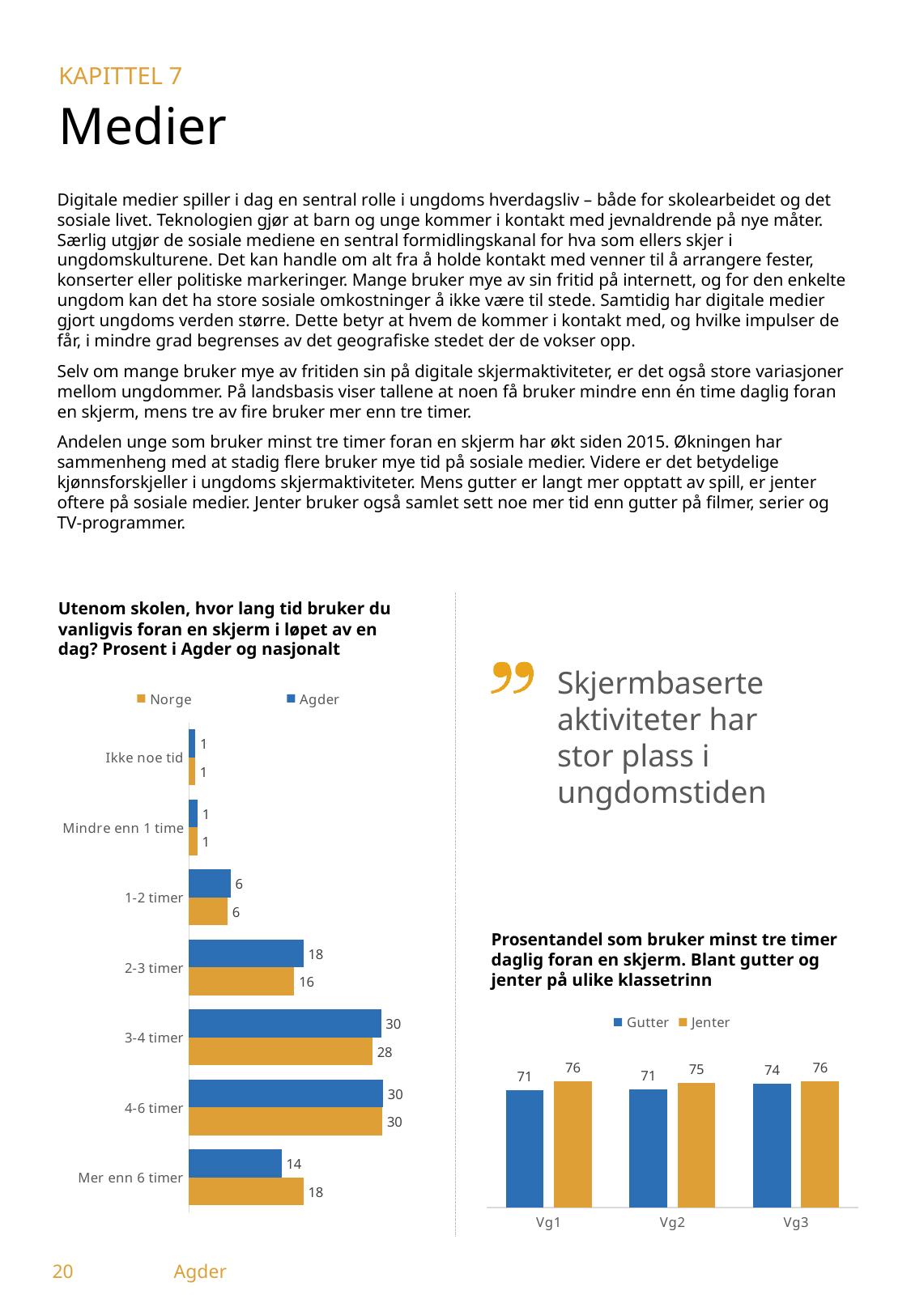
In the left chart (Utenom skolen, hvor lang tid bruker du vanligvis foran en skjerm...), what is the Agder value for 2-3 timer? 18 In the right chart (Prosentandel som bruker minst tre timer...), what is the Gutter value for Vg3? 74 In the right chart (Prosentandel som bruker minst tre timer...), which series is shown in orange? Jenter In the right chart (Prosentandel som bruker minst tre timer daglig foran en skjerm), what is the Jenter value for Vg2? 75 In the left chart (Utenom skolen...), what is the Norge value for Mer enn 6 timer? 18 In the left chart (Utenom skolen...), how many categories are shown? 7 What kind of chart is the left chart (Utenom skolen...)? Bar chart In the left chart (Utenom skolen...), how many series does the legend list? 2 In the right chart (Prosentandel som bruker minst tre timer...), what is the difference between the Jenter and Gutter values for Vg1? 5 In the left chart (Utenom skolen...), what is the difference between the Agder and Norge values for Mer enn 6 timer? 4 In the left chart (Utenom skolen...), what is the Norge value for 3-4 timer? 28 In the left chart (Utenom skolen...), which is larger for 2-3 timer, the Agder value or the Norge value? Agder